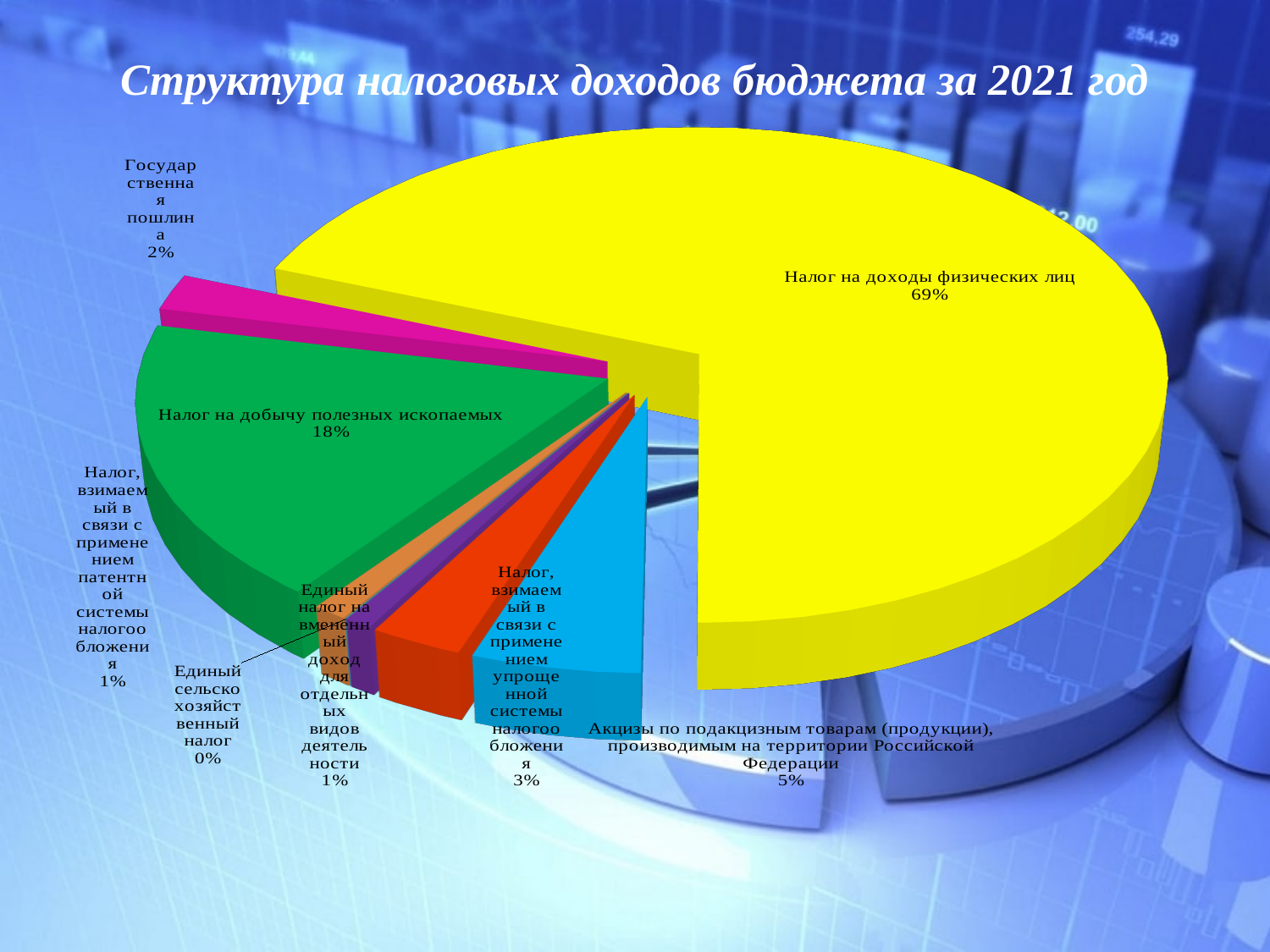
What share of the pie does "Налог на добычу полезных ископаемых" have? 18% Which category has the smallest share of the pie? Единый сельскохозяйственный налог How many categories (slices) are shown in the pie chart? 8 What is the difference in percentage points between "Налог на доходы физических лиц" and "Налог на добычу полезных ископаемых"? 51% What percentage is shown for "Государственная пошлина"? 2% What kind of chart is shown on the slide? Pie chart What share of the pie does "Налог на доходы физических лиц" have? 69% What percentage is shown for "Акцизы по подакцизным товарам (продукции), производимым на территории Российской Федерации"? 5% Which is larger: the share for "Акцизы по подакцизным товарам" or the share for "Государственная пошлина"? Акцизы по подакцизным товарам Which category has the largest share of the pie? Налог на доходы физических лиц What is the title of the chart? Структура налоговых доходов бюджета за 2021 год What percentage is shown for "Налог, взимаемый в связи с применением упрощенной системы налогообложения"? 3%